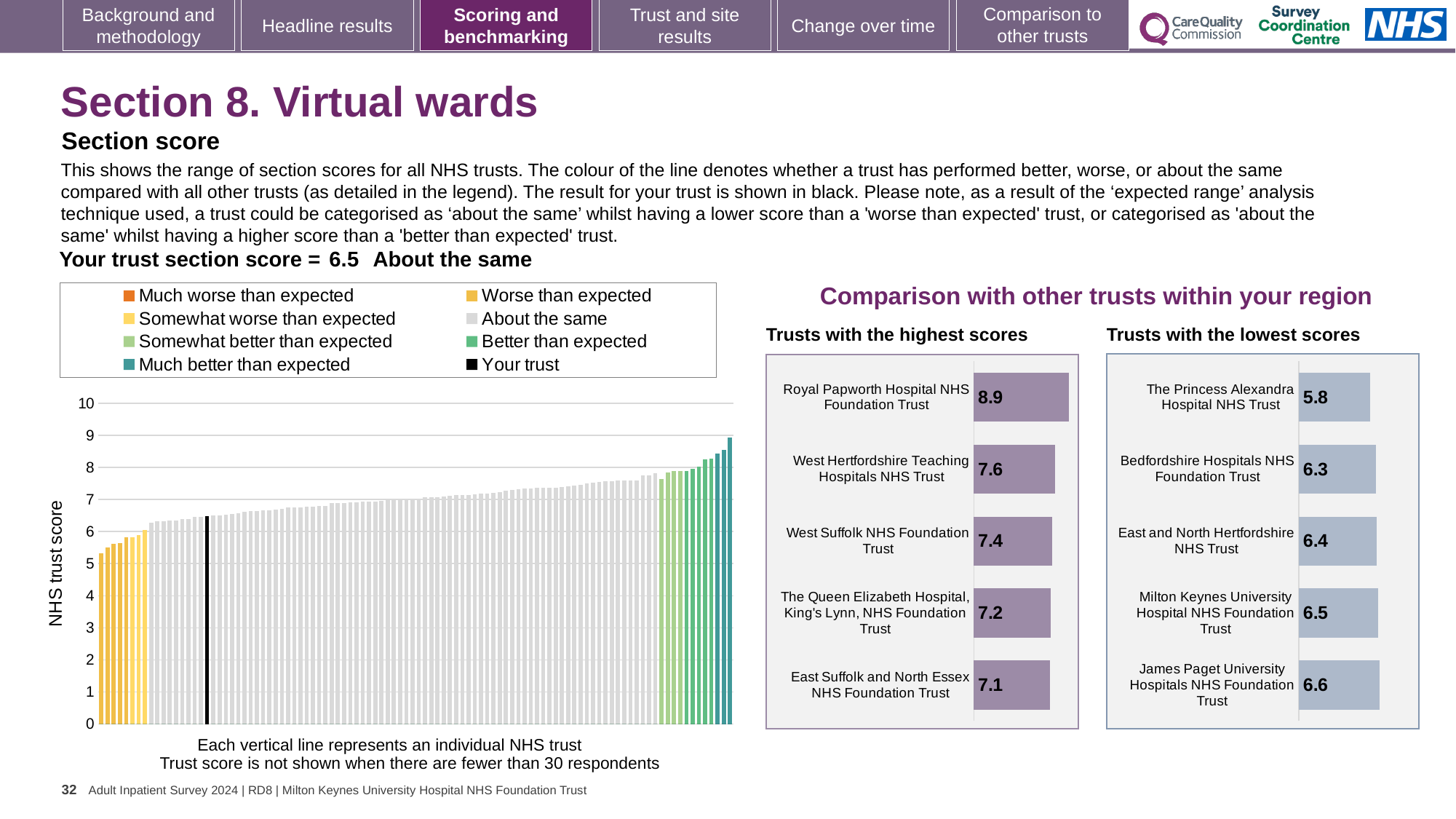
In the 'Trusts with the lowest scores' chart, which has the larger score: Bedfordshire Hospitals NHS Foundation Trust or Milton Keynes University Hospital NHS Foundation Trust? Milton Keynes University Hospital NHS Foundation Trust In the 'Trusts with the lowest scores' chart, which trust has the highest score? James Paget University Hospitals NHS Foundation Trust In the 'Trusts with the highest scores' chart, what is the score for Royal Papworth Hospital NHS Foundation Trust? 8.9 How many trusts are shown in the 'Trusts with the lowest scores' chart? 5 In the 'Trusts with the highest scores' chart, what is the difference between the scores of Royal Papworth Hospital NHS Foundation Trust and West Hertfordshire Teaching Hospitals NHS Trust? 1.3 How many entries does the legend of the main chart on the left list? 8 In the main chart on the left, do the bar values rise or fall from left to right? rise In the 'Trusts with the highest scores' chart, which trust has the lowest score? East Suffolk and North Essex NHS Foundation Trust In the main chart on the left, is the value for the black bar (your trust) greater or less than 7? less In the 'Trusts with the highest scores' chart, what is the score for West Suffolk NHS Foundation Trust? 7.4 In the 'Trusts with the lowest scores' chart, what is the score for The Princess Alexandra Hospital NHS Trust? 5.8 In the 'Trusts with the lowest scores' chart, what is the score for James Paget University Hospitals NHS Foundation Trust? 6.6